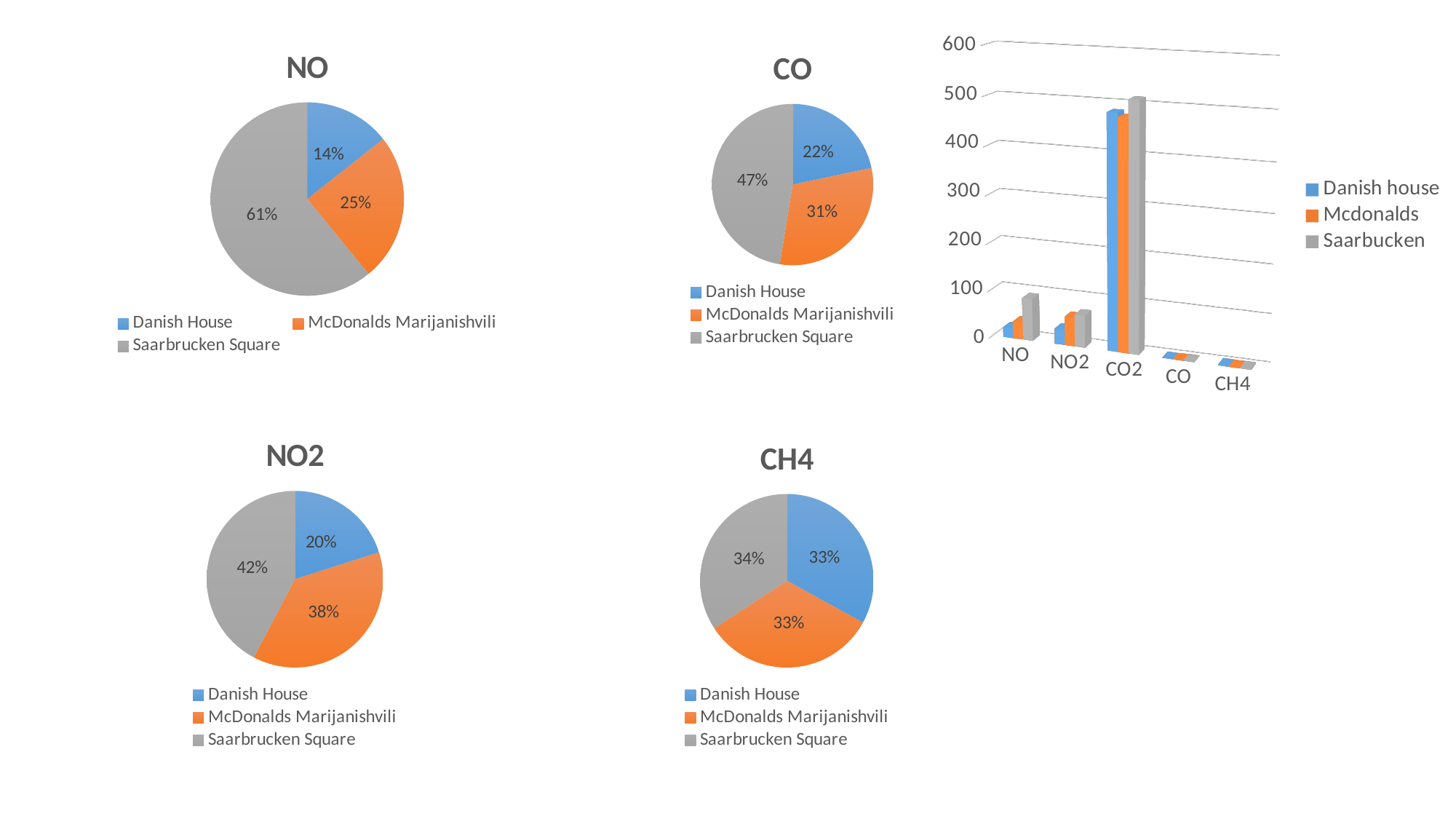
In the NO2 pie chart, which location has the largest share? Saarbrucken Square What kind of chart is the chart on the right side of the slide? Bar chart In the CO pie chart, what share does McDonalds Marijanishvili have? 31% How many series does the legend of the bar chart on the right list? 3 In the CO pie chart, what is the difference between the Saarbrucken Square share and the Danish House share? 25% In the NO pie chart, what share does Saarbrucken Square have? 61% How many pie charts are on the slide? 4 In the bar chart on the right, is the Saarbucken value for CO2 greater or less than 400? greater In the NO pie chart, which location has the smallest share? Danish House In the bar chart on the right, which category has the highest values? CO2 In the NO2 pie chart, which is larger: the McDonalds Marijanishvili share or the Danish House share? McDonalds Marijanishvili In the CH4 pie chart, what share does Saarbrucken Square have? 34%